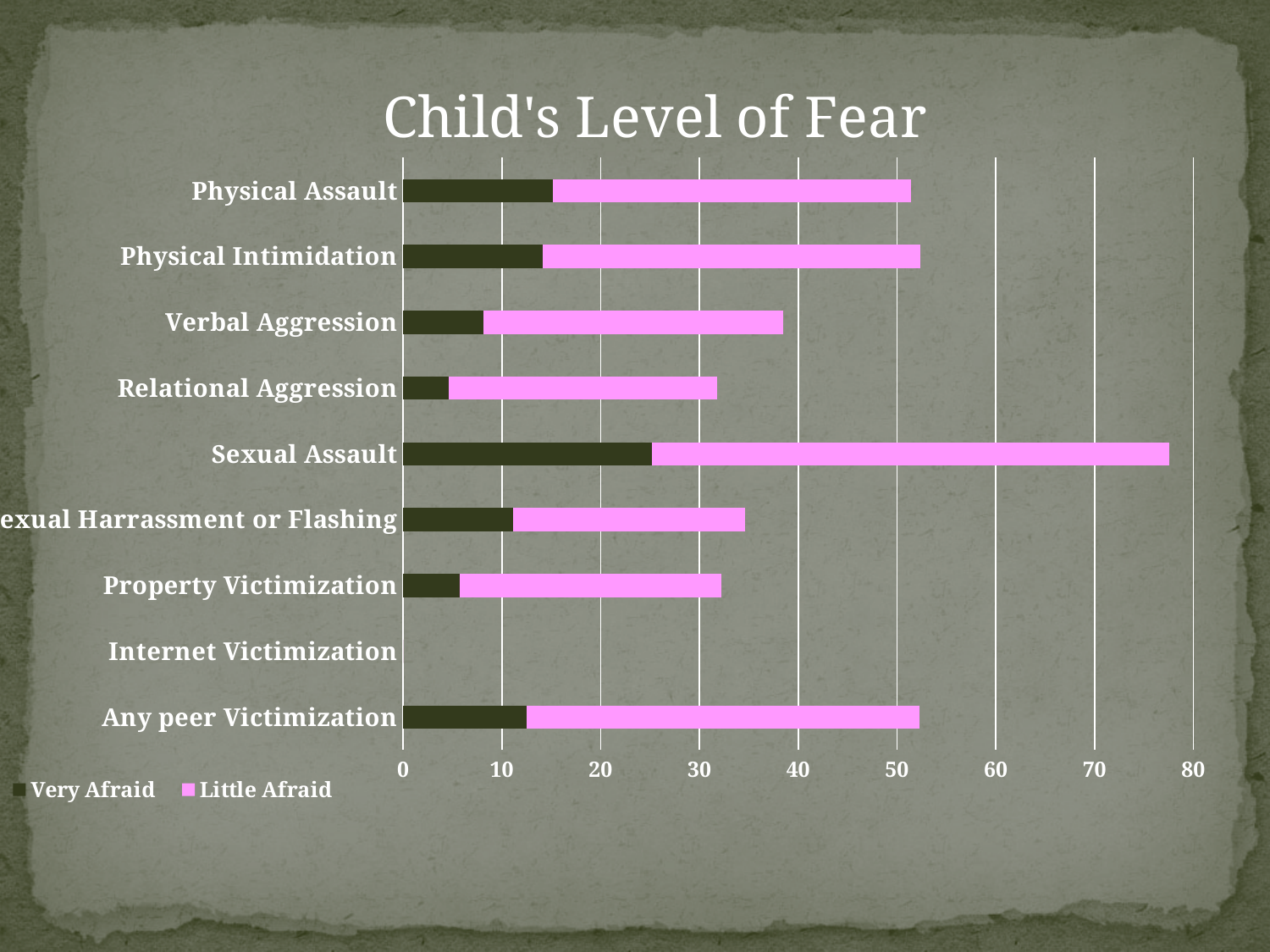
Which category shows no bar at all? Internet Victimization How many categories are shown on the vertical axis of the chart? 9 Which has the larger total bar, Sexual Assault or Verbal Aggression? Sexual Assault What kind of chart is shown on the slide? Stacked bar chart Is the total bar for Verbal Aggression greater or less than 40? less Which colour represents the Little Afraid series? Pink Is the Very Afraid value for Sexual Assault greater or less than 20? greater Is the Very Afraid value for Relational Aggression greater or less than 10? less Which category has the longest total bar? Sexual Assault How many series does the legend list? 2 What is the title of the chart? Child's Level of Fear